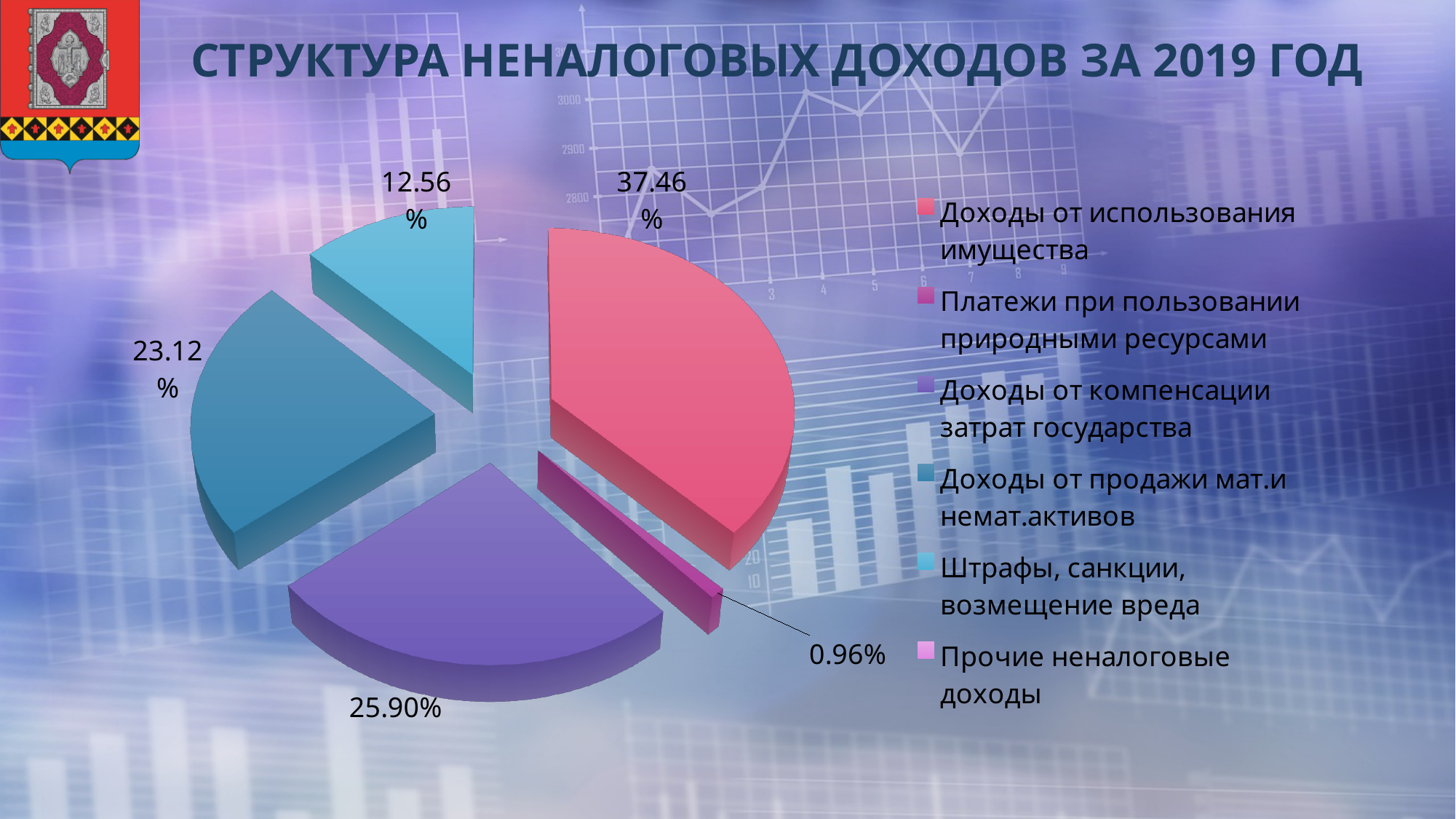
What share of non-tax revenue is 'Платежи при пользовании природными ресурсами'? 0.96% Which is larger: the share for 'Доходы от продажи мат.и немат.активов' or for 'Штрафы, санкции, возмещение вреда'? Доходы от продажи мат.и немат.активов How many entries does the chart legend list? 6 What share of non-tax revenue is 'Доходы от продажи мат.и немат.активов'? 23.12% What is the difference in percentage points between 'Доходы от использования имущества' and 'Доходы от компенсации затрат государства'? 11.56 What type of chart is shown on the slide? pie chart What share of non-tax revenue is 'Доходы от компенсации затрат государства'? 25.90% Which labelled slice has the smallest share of non-tax revenue? Платежи при пользовании природными ресурсами What share of non-tax revenue is 'Доходы от использования имущества'? 37.46% What is the title of the chart on the slide? СТРУКТУРА НЕНАЛОГОВЫХ ДОХОДОВ ЗА 2019 ГОД What share of non-tax revenue is 'Штрафы, санкции, возмещение вреда'? 12.56% Which category has the largest share of non-tax revenue? Доходы от использования имущества